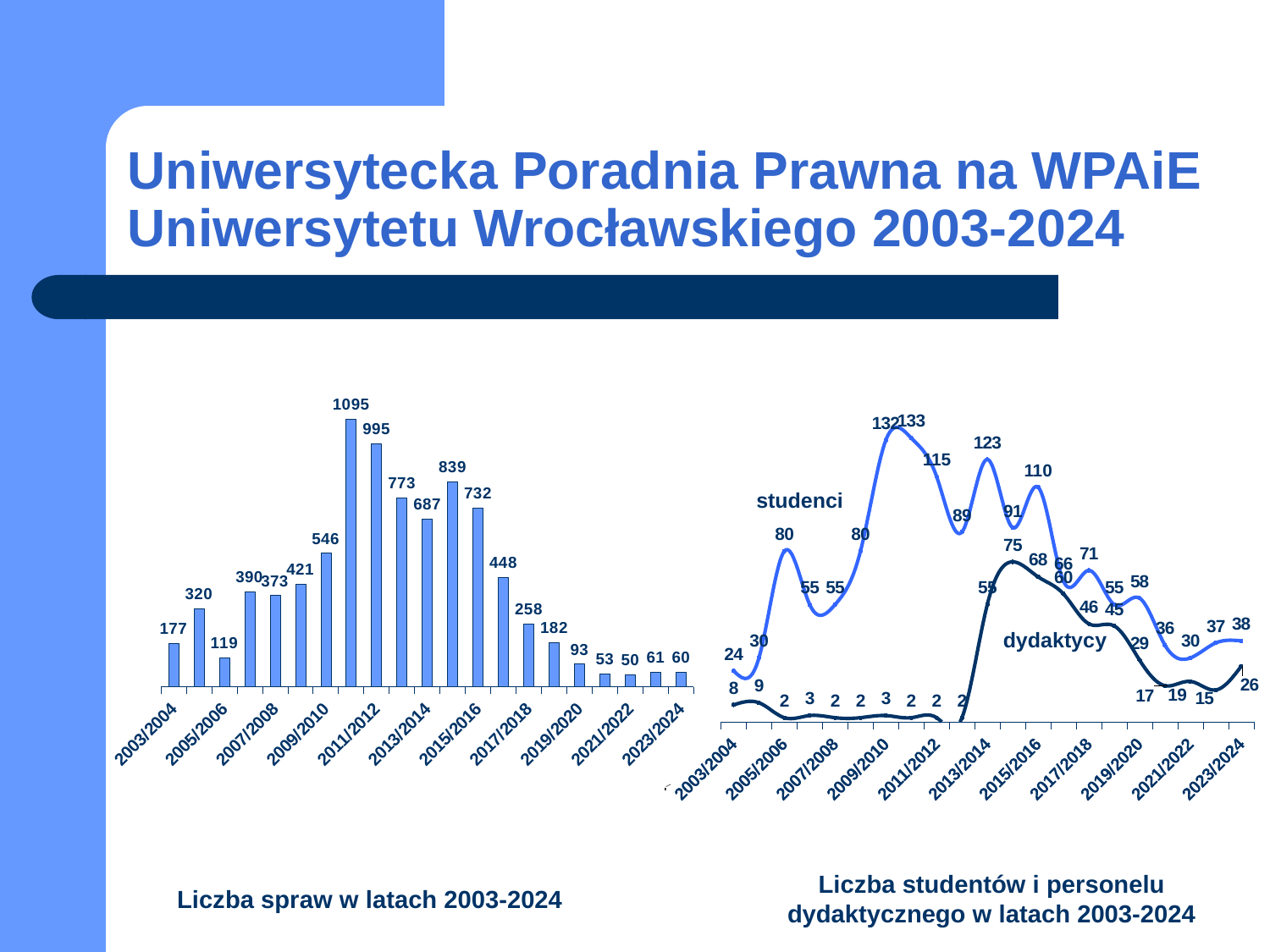
On the right chart (Liczba studentów i personelu dydaktycznego), what is the value for studenci in 2003/2004? 24 On the left chart (Liczba spraw w latach 2003-2024), how many bars are plotted? 21 On the right chart (Liczba studentów i personelu dydaktycznego), what is the highest value reached by the dydaktycy series? 75 On the left chart (Liczba spraw w latach 2003-2024), what is the difference between the two highest bars, 1095 and 995? 100 On the right chart (Liczba studentów i personelu dydaktycznego), how many series are plotted? 2 On the right chart (Liczba studentów i personelu dydaktycznego), what is the difference between studenci (38) and dydaktycy (26) in 2023/2024? 12 On the left chart (Liczba spraw w latach 2003-2024), which is larger: the value for 2005/2006 or the value for 2007/2008? 2007/2008 On the left chart (Liczba spraw w latach 2003-2024), what is the highest value shown? 1095 On the left chart (Liczba spraw w latach 2003-2024), which year has the highest number of cases? 2010/2011 What kind of chart is the left chart (Liczba spraw w latach 2003-2024)? Bar chart On the left chart (Liczba spraw w latach 2003-2024), what is the value for 2003/2004? 177 On the left chart (Liczba spraw w latach 2003-2024), what is the value for 2023/2024? 60